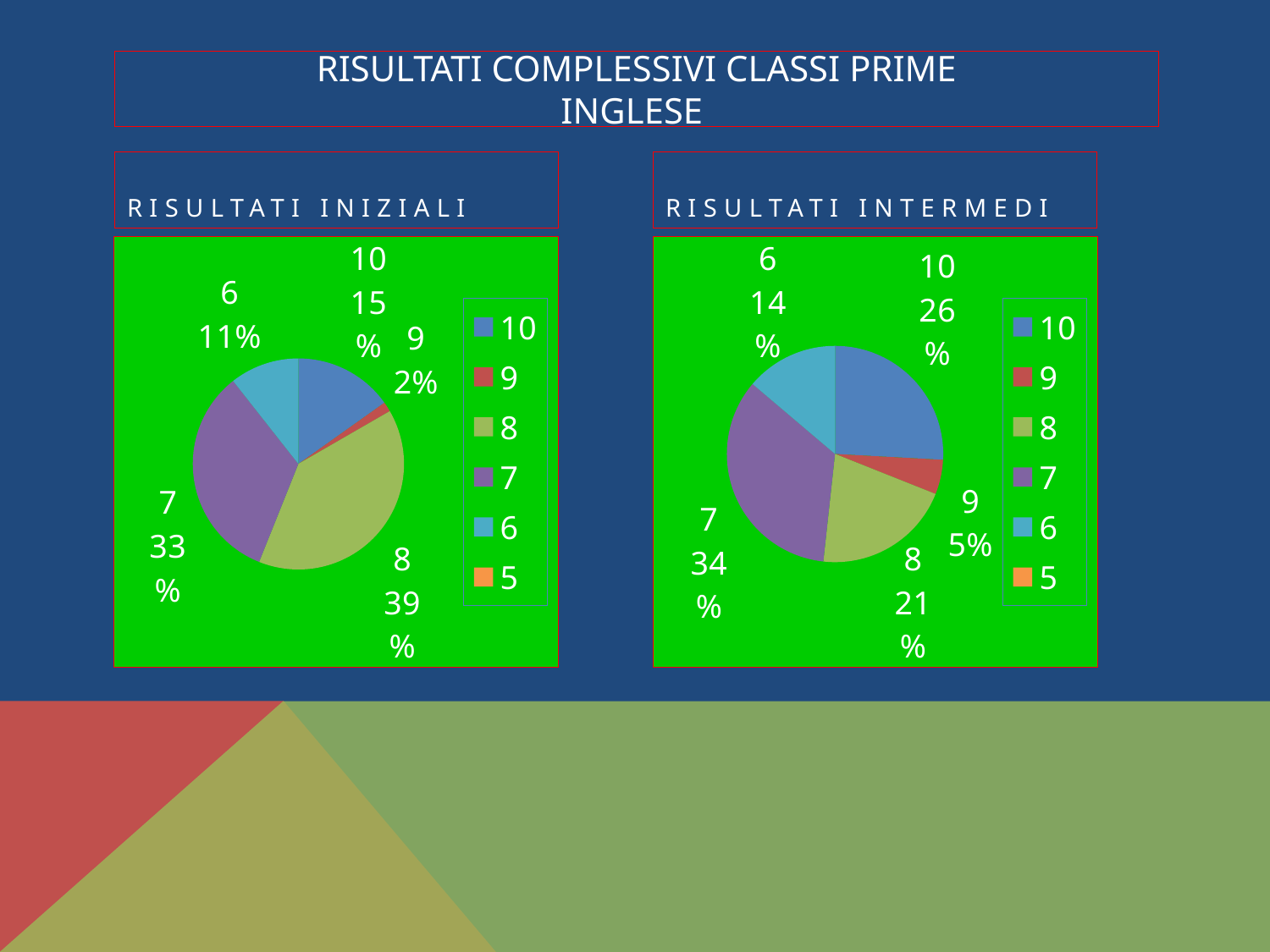
How many entries does the legend of the RISULTATI INIZIALI chart list? 6 In the RISULTATI INIZIALI chart, which category has the largest slice? 8 In the RISULTATI INTERMEDI chart, what is the difference between the shares of category 7 and category 8? 13% What is the title of the chart on the right of the slide? RISULTATI INTERMEDI In the RISULTATI INTERMEDI chart, what share does category 10 have? 26% What kind of chart is the RISULTATI INTERMEDI chart? Pie chart In the RISULTATI INTERMEDI chart, which category has the largest slice? 7 In the RISULTATI INTERMEDI chart, what share does category 6 have? 14% In the RISULTATI INIZIALI chart, what share does category 8 have? 39% In the RISULTATI INIZIALI chart, which labelled category has the smallest slice? 9 In the RISULTATI INIZIALI chart, which is larger, the share of category 10 or the share of category 6? 10 In the RISULTATI INIZIALI chart, what share does category 7 have? 33%